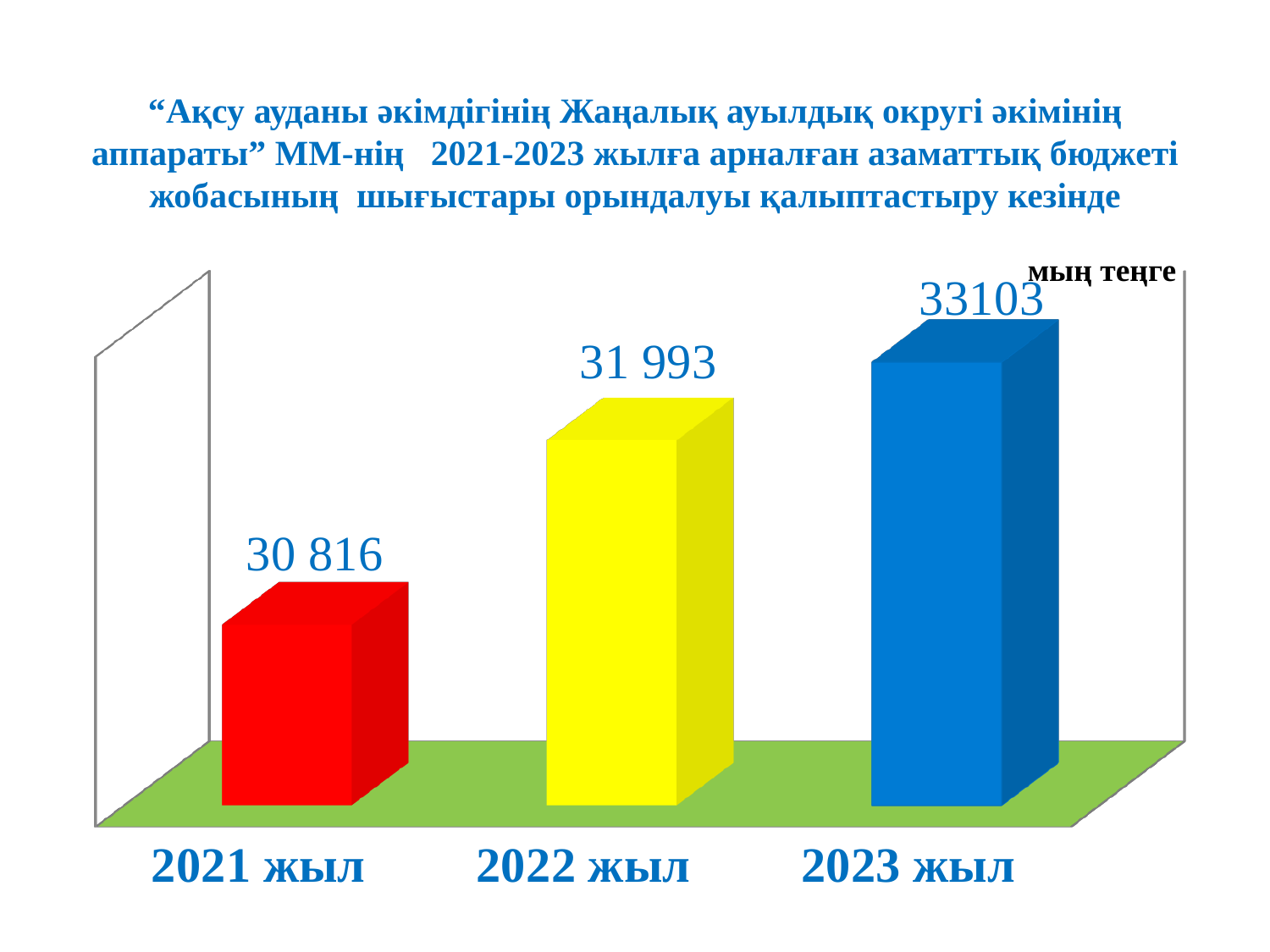
What is the difference between the values for 2023 жыл and 2022 жыл? 1 110 What is the value for 2023 жыл? 33103 Which year has the highest value? 2023 жыл How many bars are shown in the chart? 3 What is the difference between the values for 2023 жыл and 2021 жыл? 2 287 What is the difference between the values for 2022 жыл and 2021 жыл? 1 177 Which is larger, the value for 2021 жыл or the value for 2022 жыл? 2022 жыл Do the values rise or fall from 2021 жыл to 2023 жыл? rise What is the value for 2021 жыл? 30 816 Which year has the lowest value? 2021 жыл What is the value for 2022 жыл? 31 993 What kind of chart is shown on the slide? bar chart